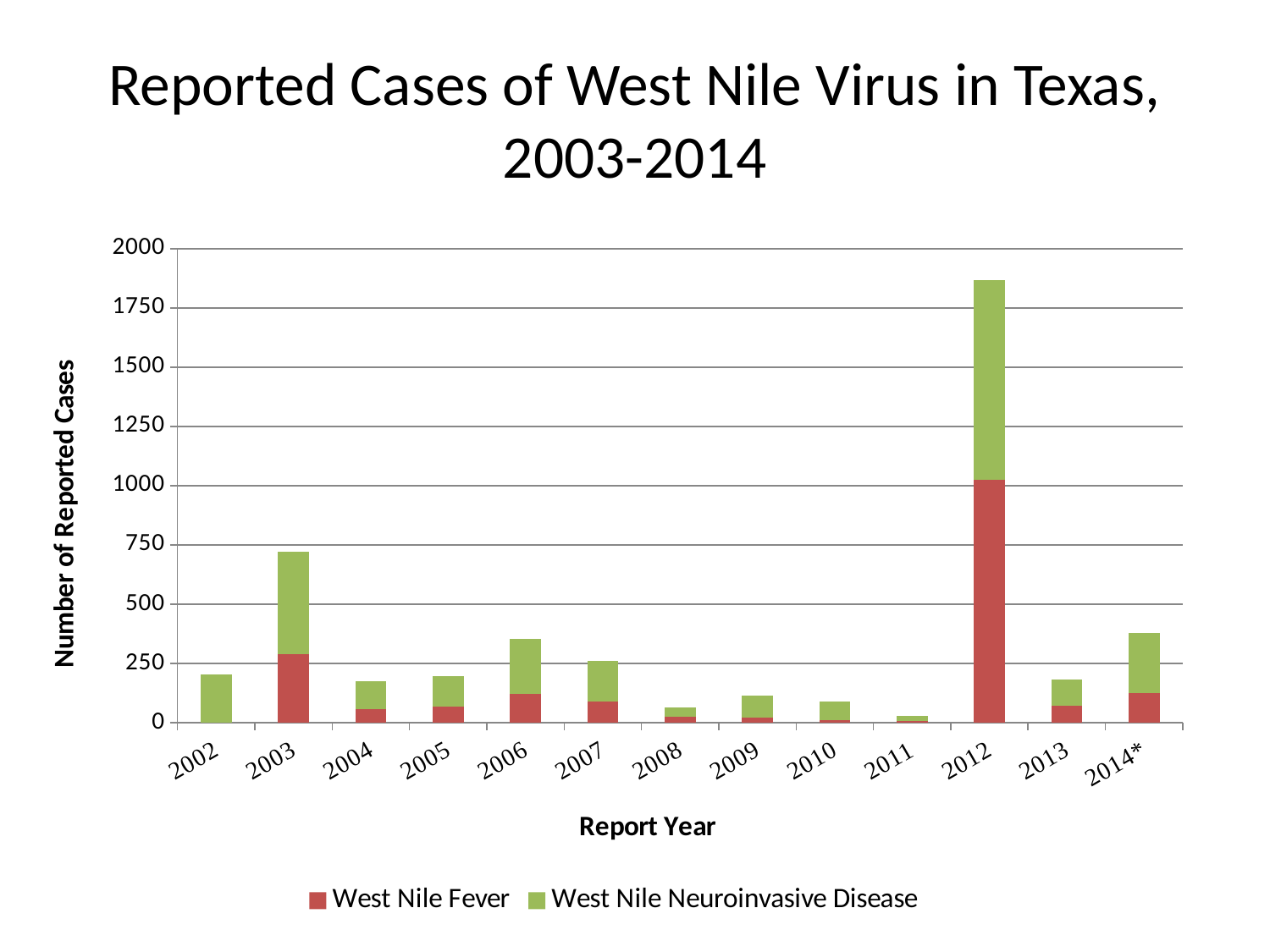
Is the total number of reported cases in 2012 greater or less than 1750? greater What kind of chart is shown on the slide? Stacked bar chart Is the number of West Nile Fever cases in 2012 greater or less than 750? greater Which year has a larger total number of reported cases, 2003 or 2006? 2003 Which report year has the highest total number of reported cases? 2012 How many report years are shown on the x axis? 13 Is the total number of reported cases in 2008 greater or less than 250? less How many series does the legend list? 2 Which report year has the lowest total number of reported cases? 2011 What is the title of the vertical axis? Number of Reported Cases Which year has a larger total number of reported cases, 2013 or 2014*? 2014*